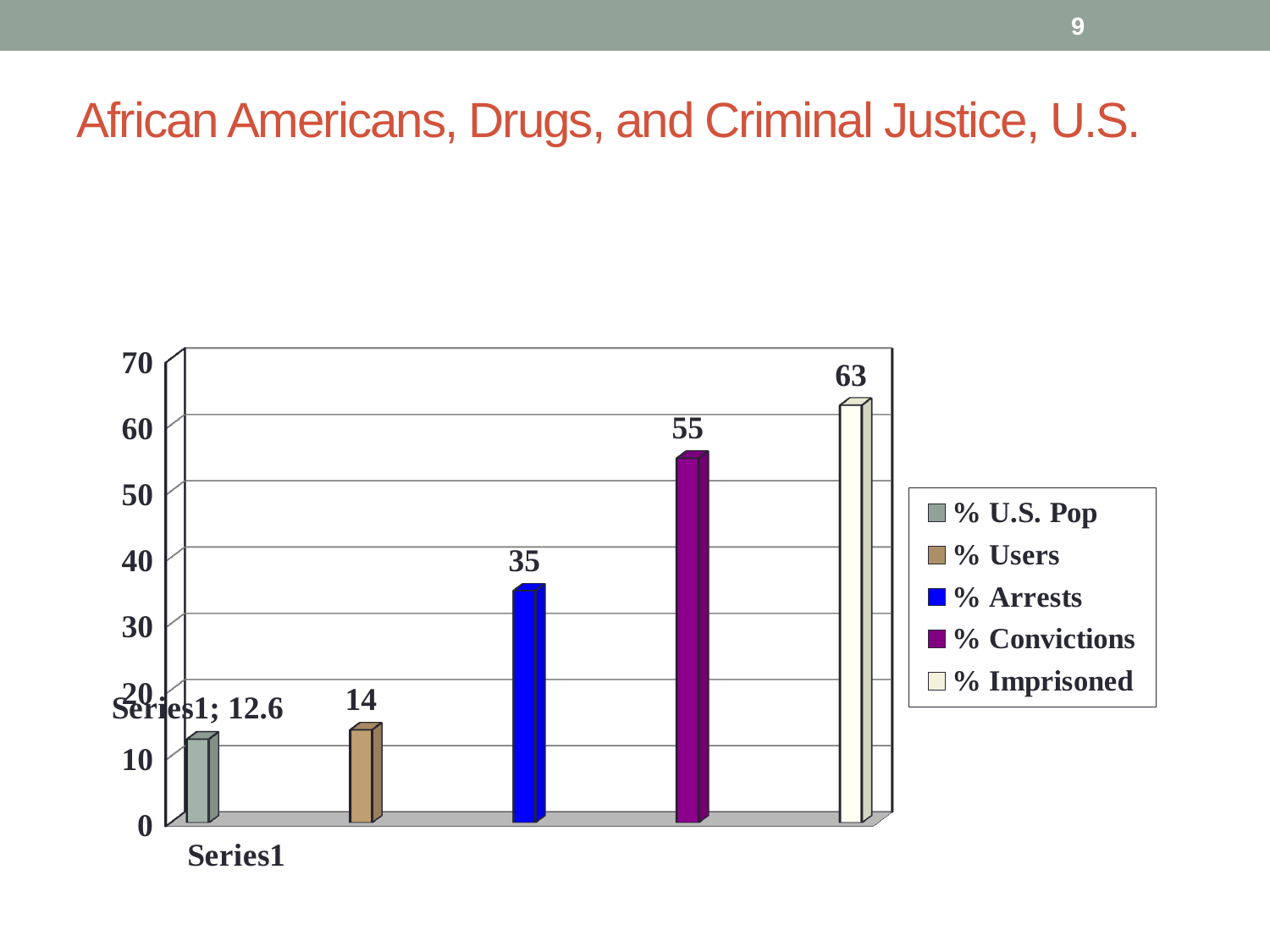
Which is larger, the value for % Arrests or the value for % Users? % Arrests What kind of chart is shown on the slide? Bar chart What is the value for % Arrests? 35 What is the difference between the values for % Users and % U.S. Pop? 1.4 What colour is the bar for % Arrests? Blue How many series does the legend list? 5 What is the value for % Convictions? 55 What is the difference between the values for % Imprisoned and % Convictions? 8 Which legend entry has the lowest value? % U.S. Pop Which legend entry has the highest value? % Imprisoned What is the value for % Imprisoned? 63 What is the value for % U.S. Pop? 12.6